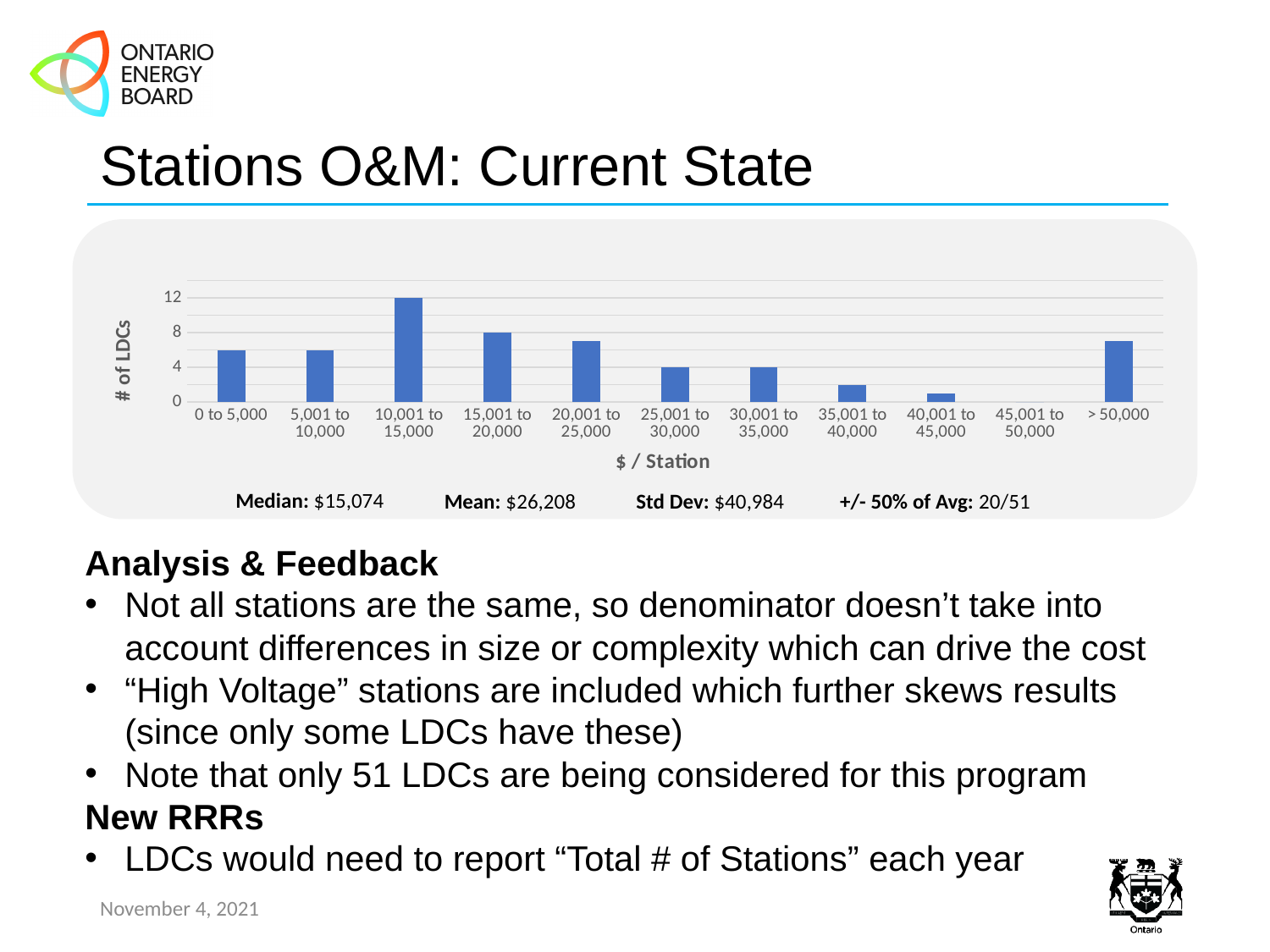
What is the difference in # of LDCs between the 10,001 to 15,000 and 15,001 to 20,000 categories? 4 What kind of chart is shown on the slide? bar chart Which $ / Station category has the lowest number of LDCs? 45,001 to 50,000 Is the # of LDCs for the 35,001 to 40,000 category greater or less than 4? less Which $ / Station category has the highest number of LDCs? 10,001 to 15,000 Which has more LDCs: the 10,001 to 15,000 category or the > 50,000 category? 10,001 to 15,000 How many LDCs are in the 25,001 to 30,000 $ / Station category? 4 How many LDCs are in the 15,001 to 20,000 $ / Station category? 8 What is the title of the chart's x axis? $ / Station How many $ / Station categories are shown on the x axis? 11 Is the # of LDCs for the 0 to 5,000 category greater or less than 4? greater How many LDCs are in the 10,001 to 15,000 $ / Station category? 12